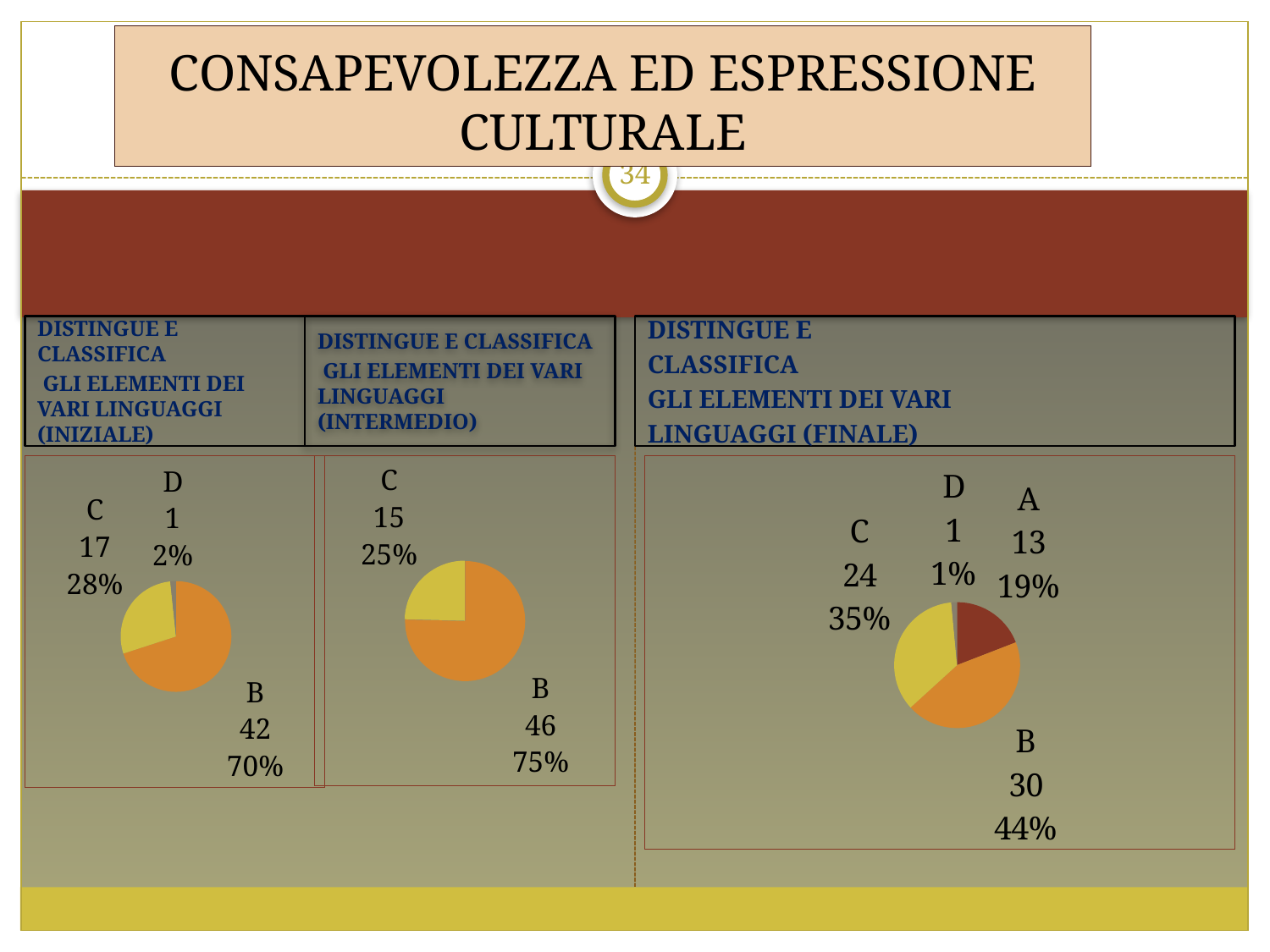
In the INTERMEDIO pie chart (middle), what share of the pie does category B have? 75% In the INIZIALE pie chart (left), what share of the pie does category C have? 28% In the FINALE pie chart (right), which category is the largest? B In the INIZIALE pie chart (left), what is the value for category B? 42 In the FINALE pie chart (right), which is larger, the value for C or the value for A? C What type of chart is used on this slide? Pie chart In the INTERMEDIO pie chart (middle), what is the value for category C? 15 In the INTERMEDIO pie chart (middle), how many categories are shown? 2 In the FINALE pie chart (right), how many categories are shown? 4 In the FINALE pie chart (right), what is the difference between the values for B and C? 6 In the INIZIALE pie chart (left), which category is the smallest? D In the FINALE pie chart (right), what is the value for category A? 13